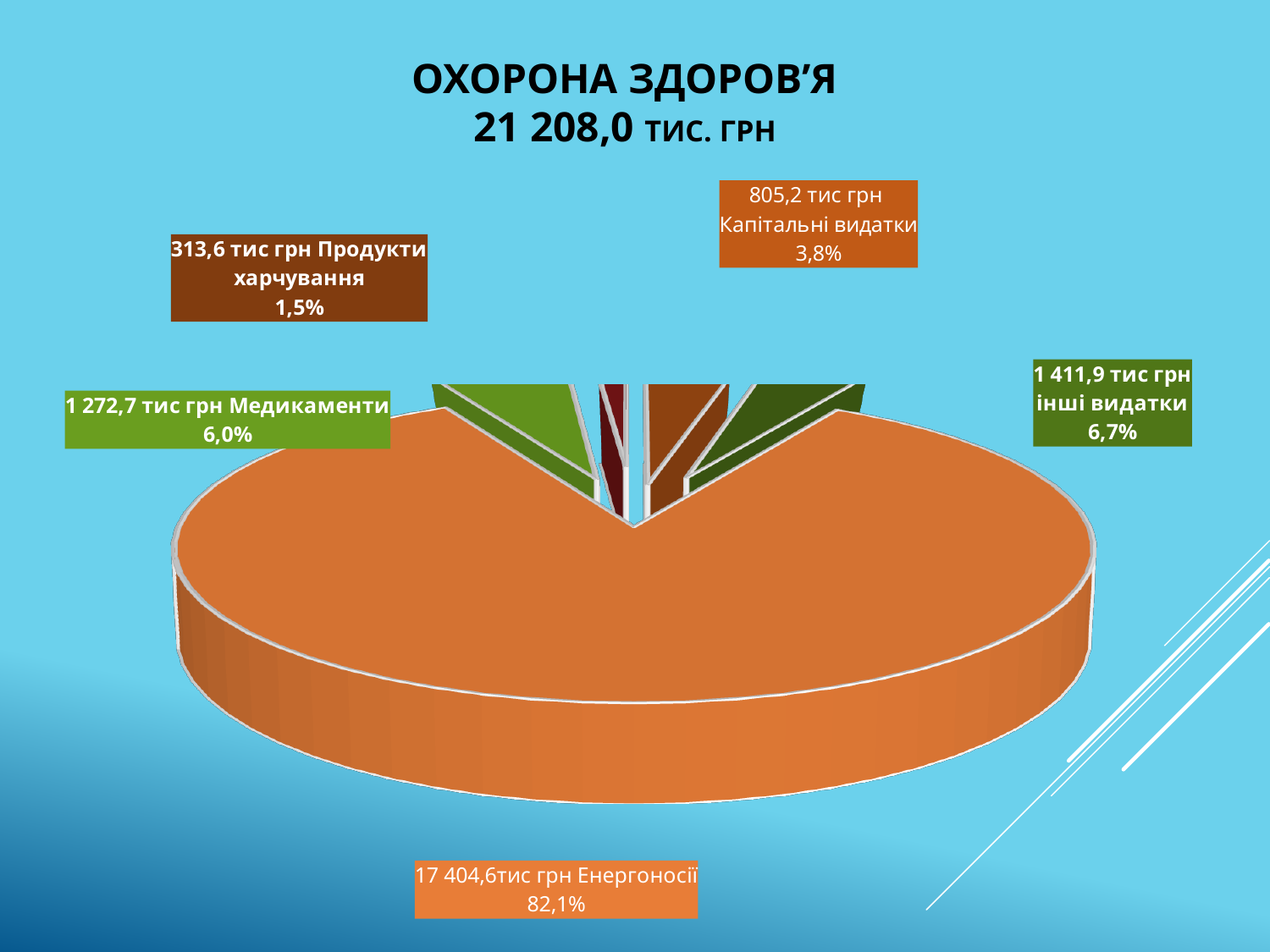
What is the value for Енергоносії? 17 404,6 тис грн What is the difference between the values for інші видатки and Капітальні видатки? 606,7 тис грн What share of the pie does Капітальні видатки take? 3,8% What kind of chart is shown on the slide? pie chart How many slices does the pie chart have? 5 Which category has the largest slice? Енергоносії Which category has the smallest slice? Продукти харчування Which is larger, інші видатки or Медикаменти? інші видатки What is the value for Продукти харчування? 313,6 тис грн What total amount is stated in the chart title? 21 208,0 тис. грн What is the value for Медикаменти? 1 272,7 тис грн What share of the pie does Енергоносії take? 82,1%